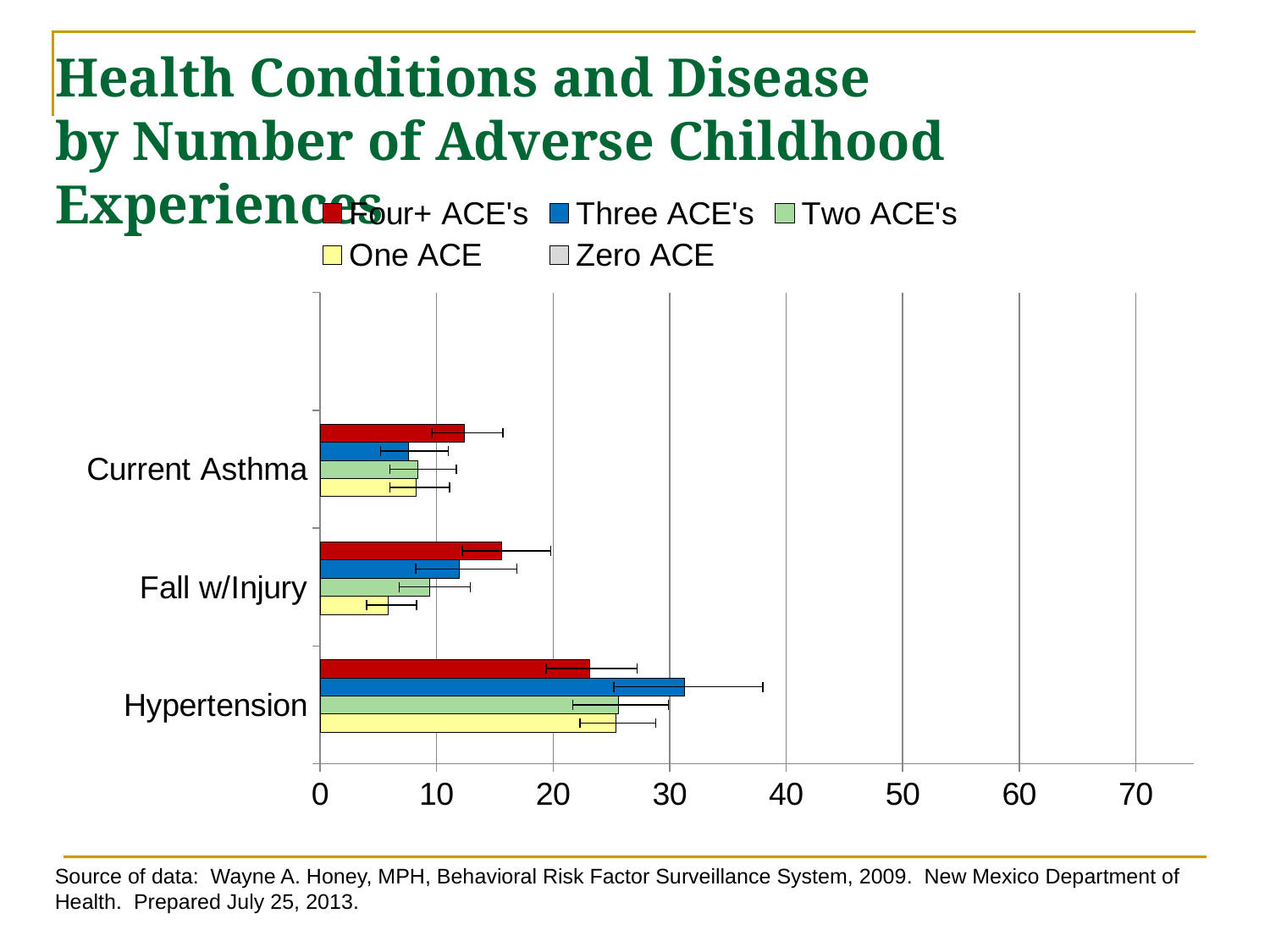
For Fall w/Injury, which is larger: the Four+ ACE's value or the One ACE value? Four+ ACE's What colour represents the Four+ ACE's series in the legend? Red How many series does the legend list? 5 Which health condition has the highest Four+ ACE's value? Hypertension Is the Four+ ACE's value for Fall w/Injury greater or less than 20? less Is the One ACE value for Fall w/Injury greater or less than 10? less Is the Three ACE's value for Hypertension greater or less than 20? greater How many health conditions are labeled on the vertical axis? 3 Which health condition has the lowest One ACE value? Fall w/Injury For Hypertension, which is larger: the Three ACE's value or the Four+ ACE's value? Three ACE's What kind of chart is shown on the slide? Bar chart